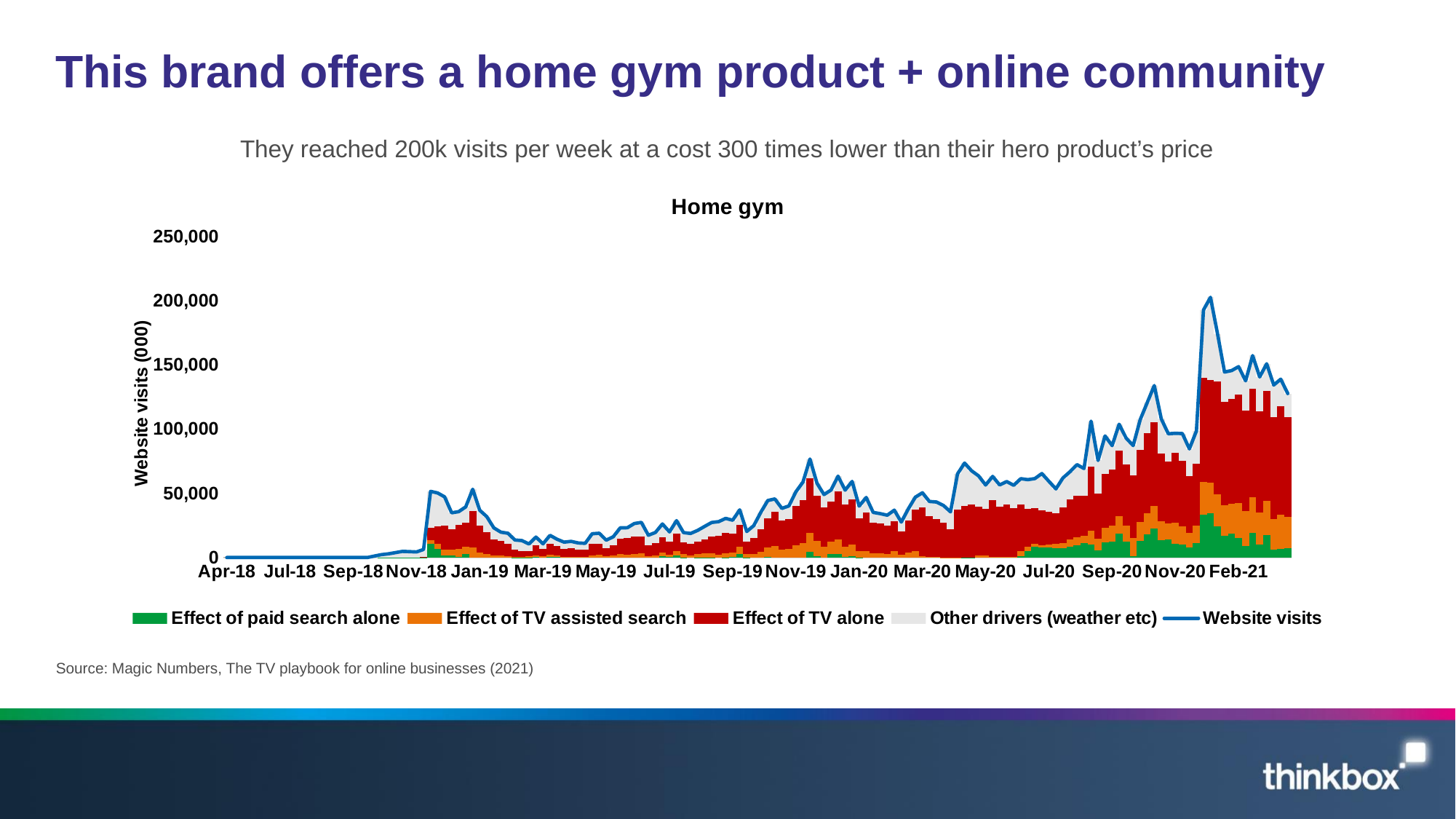
Which stacked series contributes the largest share of website visits in early 2021? Effect of TV alone Which series is plotted as a line rather than a stacked area? Website visits What is the highest value shown on the vertical axis? 250,000 How many series does the chart legend list? 5 Is the value of the Website visits line at Apr-18 greater or less than 50,000? less Is the peak value of the Website visits line greater or less than 150,000? greater What is the label on the vertical axis of the chart? Website visits (000) What is the title of the chart? Home gym Overall, do website visits rise or fall from Apr-18 to Feb-21? rise Is the value of the Website visits line at Jul-19 greater or less than 100,000? less